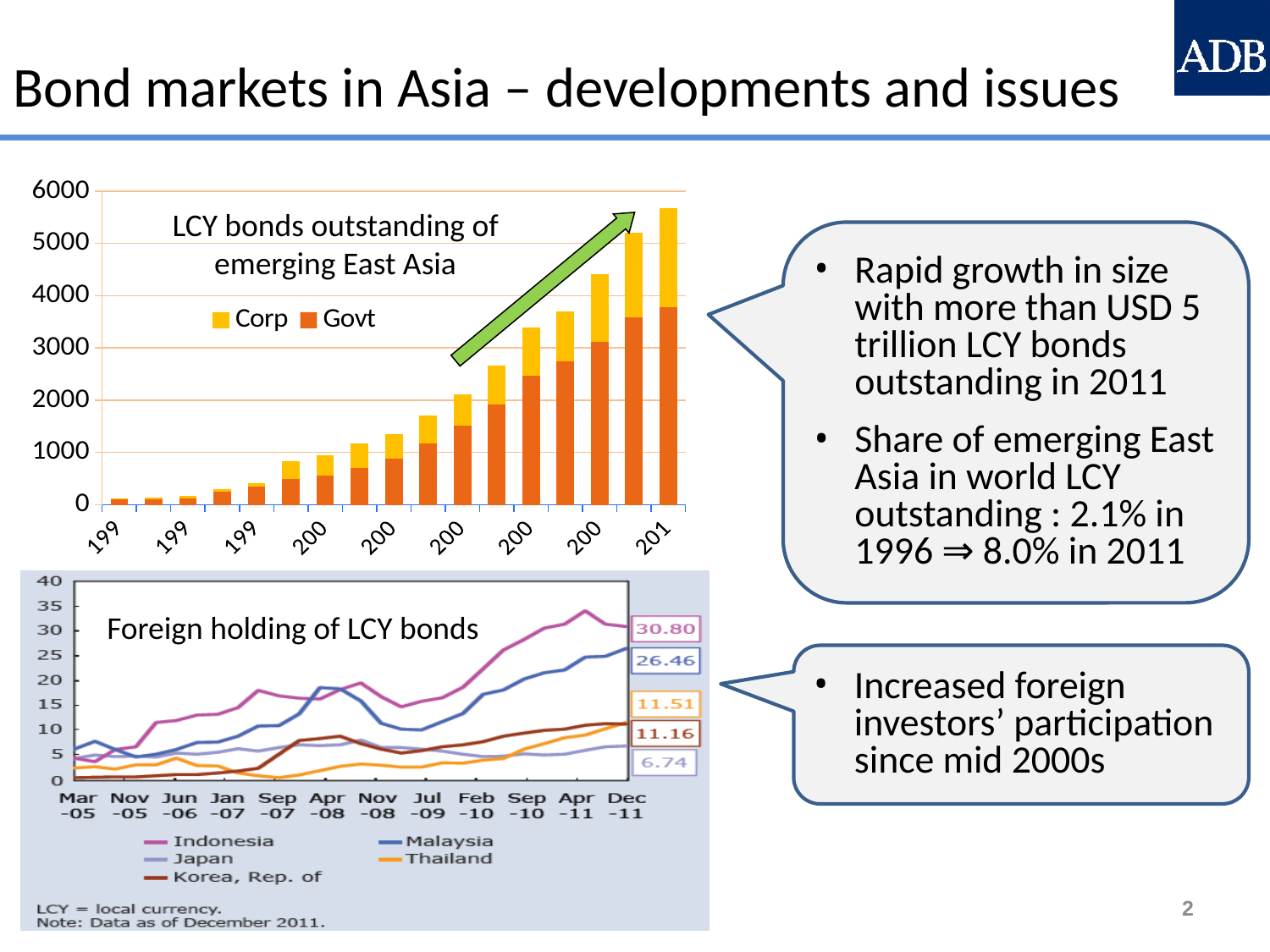
In the 'Foreign holding of LCY bonds' chart, which country has the highest value at the end of the series? Indonesia In the 'LCY bonds outstanding of emerging East Asia' chart, do the total values rise or fall along the x axis? Rise What kind of chart is the 'LCY bonds outstanding of emerging East Asia' chart? Stacked bar chart How many series does the legend of the 'Foreign holding of LCY bonds' chart list? 5 In the 'Foreign holding of LCY bonds' chart, what is the value shown for Indonesia at the end of the series? 30.80 In the 'Foreign holding of LCY bonds' chart, which country has the lowest value at the end of the series? Japan In the 'Foreign holding of LCY bonds' chart, which has the larger end value, Thailand or Korea, Rep. of? Thailand In the 'LCY bonds outstanding of emerging East Asia' chart, is the total of the last (rightmost) bar greater or less than 5000? greater In the 'Foreign holding of LCY bonds' chart, what is the value shown for Malaysia at the end of the series? 26.46 In the 'Foreign holding of LCY bonds' chart, what is the difference between the end values for Indonesia and Malaysia? 4.34 Which two series does the legend of the 'LCY bonds outstanding of emerging East Asia' chart list? Corp and Govt In the 'Foreign holding of LCY bonds' chart, what is the value shown for Japan at the end of the series? 6.74